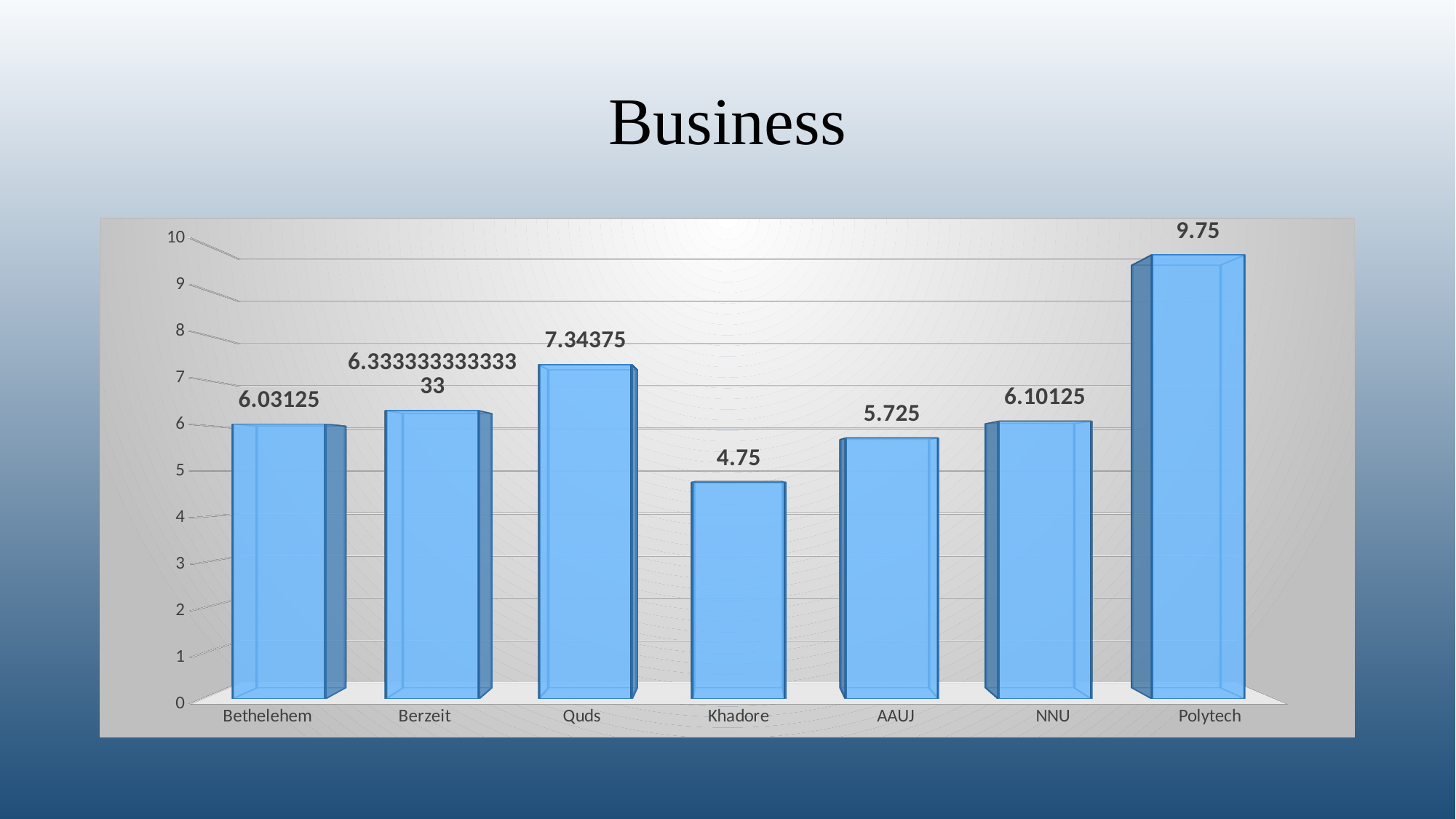
What is the difference between the values for Polytech and Khadore? 5 What is the title of the slide? Business What kind of chart is shown on the slide? bar chart Which category has the highest value? Polytech What is the value for Polytech? 9.75 How many categories are shown on the x axis? 7 What is the value for Khadore? 4.75 Is the value for Khadore greater or less than 5? less Which is larger, the value for Quds or the value for NNU? Quds What is the value for Quds? 7.34375 Which category has the lowest value? Khadore What is the value for AAUJ? 5.725